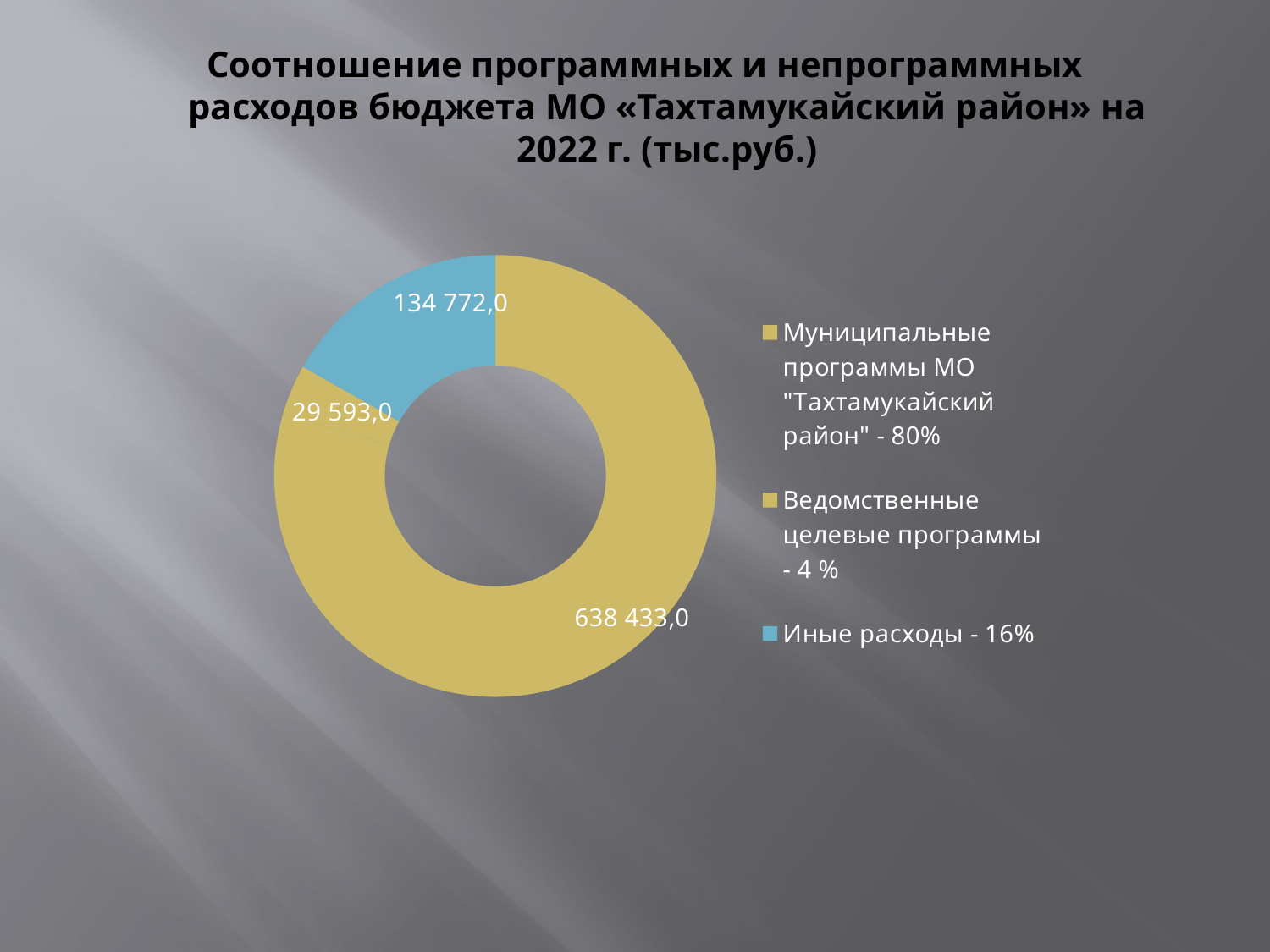
What kind of chart is shown on the slide? doughnut chart What is the value for Иные расходы? 134 772,0 What share of the total do Иные расходы represent according to the legend? 16% What is the value for Ведомственные целевые программы? 29 593,0 Which category has the largest value? Муниципальные программы МО "Тахтамукайский район" Which is larger: the value for Иные расходы or the value for Ведомственные целевые программы? Иные расходы How many categories does the chart show? 3 What is the difference between the value for Муниципальные программы МО "Тахтамукайский район" and the value for Иные расходы? 503 661,0 What is the value for Муниципальные программы МО "Тахтамукайский район"? 638 433,0 What is the total of all three values shown on the chart? 802 798,0 Which category has the smallest value? Ведомственные целевые программы What is the difference between the value for Иные расходы and the value for Ведомственные целевые программы? 105 179,0